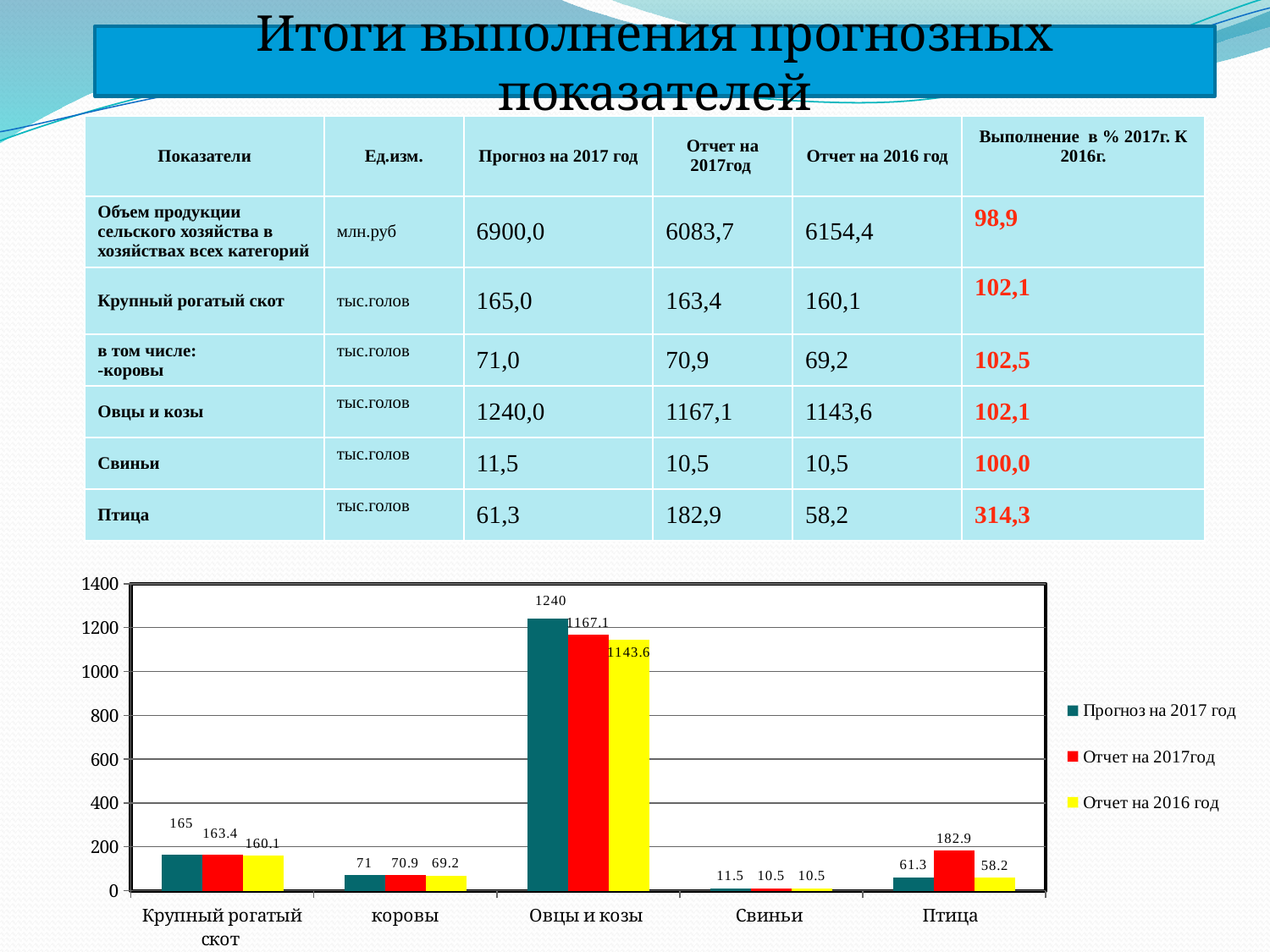
In the chart, what is the difference between 'Прогноз на 2017 год' and 'Отчет на 2016 год' for 'Овцы и козы'? 96.4 How many categories are shown on the x axis of the chart? 5 Which category has the lowest 'Отчет на 2017год' value in the chart? Свиньи What colour are the 'Отчет на 2016 год' bars in the chart? Yellow In the chart, which is larger for 'Птица': 'Прогноз на 2017 год' or 'Отчет на 2017год'? Отчет на 2017год What type of chart is shown at the bottom of the slide? Bar chart How many series does the chart legend list? 3 In the chart, what is the value of 'Отчет на 2017год' for 'Птица'? 182.9 Which category has the highest 'Прогноз на 2017 год' value in the chart? Овцы и козы In the chart, what is the value of 'Отчет на 2016 год' for 'Крупный рогатый скот'? 160.1 In the chart, what is the value of 'Прогноз на 2017 год' for 'Овцы и козы'? 1240 In the chart, is the 'Отчет на 2017год' value for 'Овцы и козы' greater or less than 1000? greater